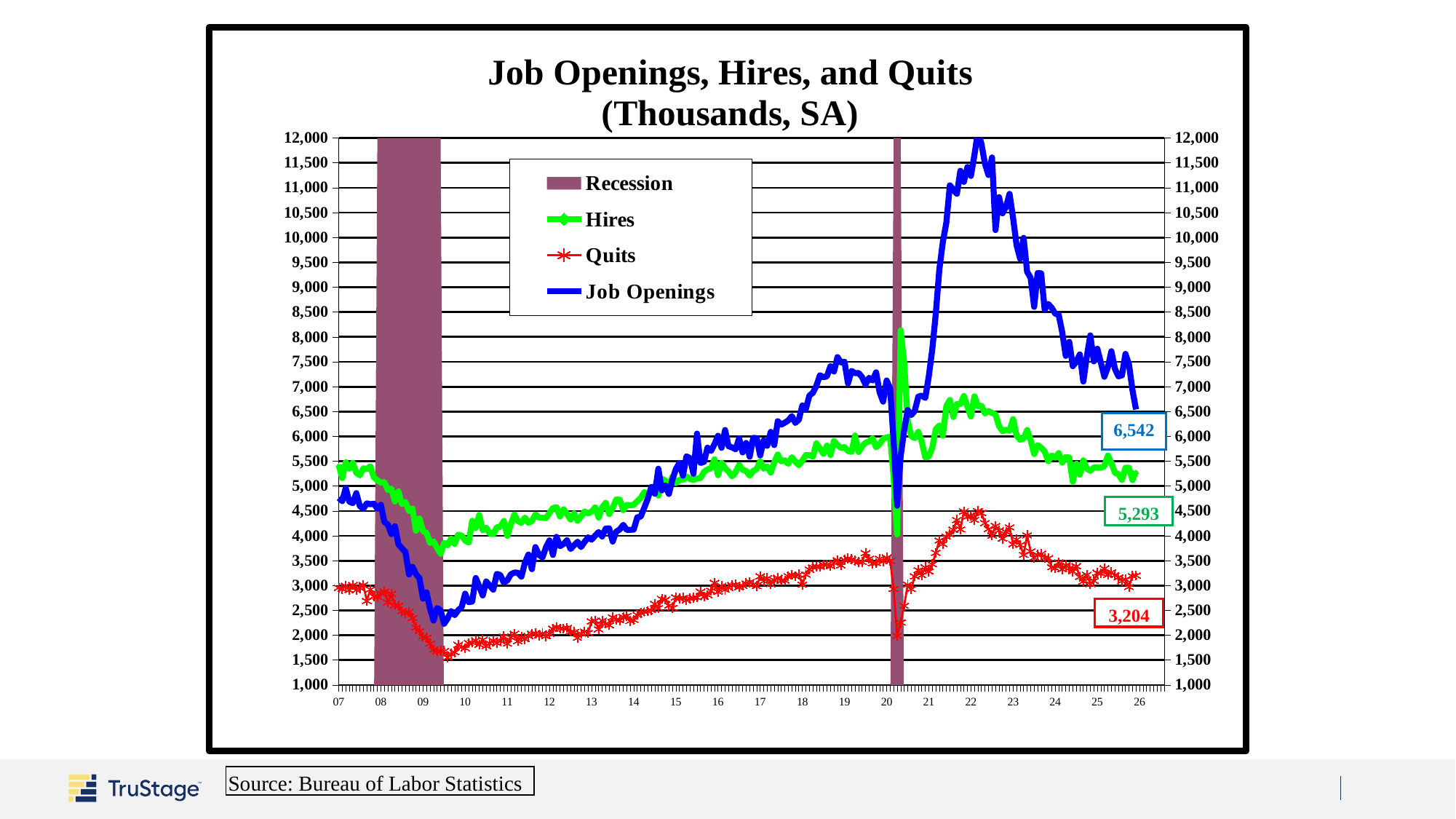
Which series has the highest latest labelled value? Job Openings What is the difference between the latest labelled Job Openings value and the latest labelled Hires value? 1,249 What is the latest labelled value for Hires? 5,293 How many entries does the chart's legend list? 4 What kind of chart is shown on the slide? line chart What is the difference between the latest labelled Hires value and the latest labelled Quits value? 2,089 What is the title of the chart? Job Openings, Hires, and Quits (Thousands, SA) Does the Job Openings line rise or fall from 2022 to 2026? fall What is the latest labelled value for Job Openings? 6,542 Is the lowest point of the Quits line around 2009 greater or less than 2,000? less What is the latest labelled value for Quits? 3,204 Is the peak of the Job Openings line around 2022 greater or less than 11,500? greater